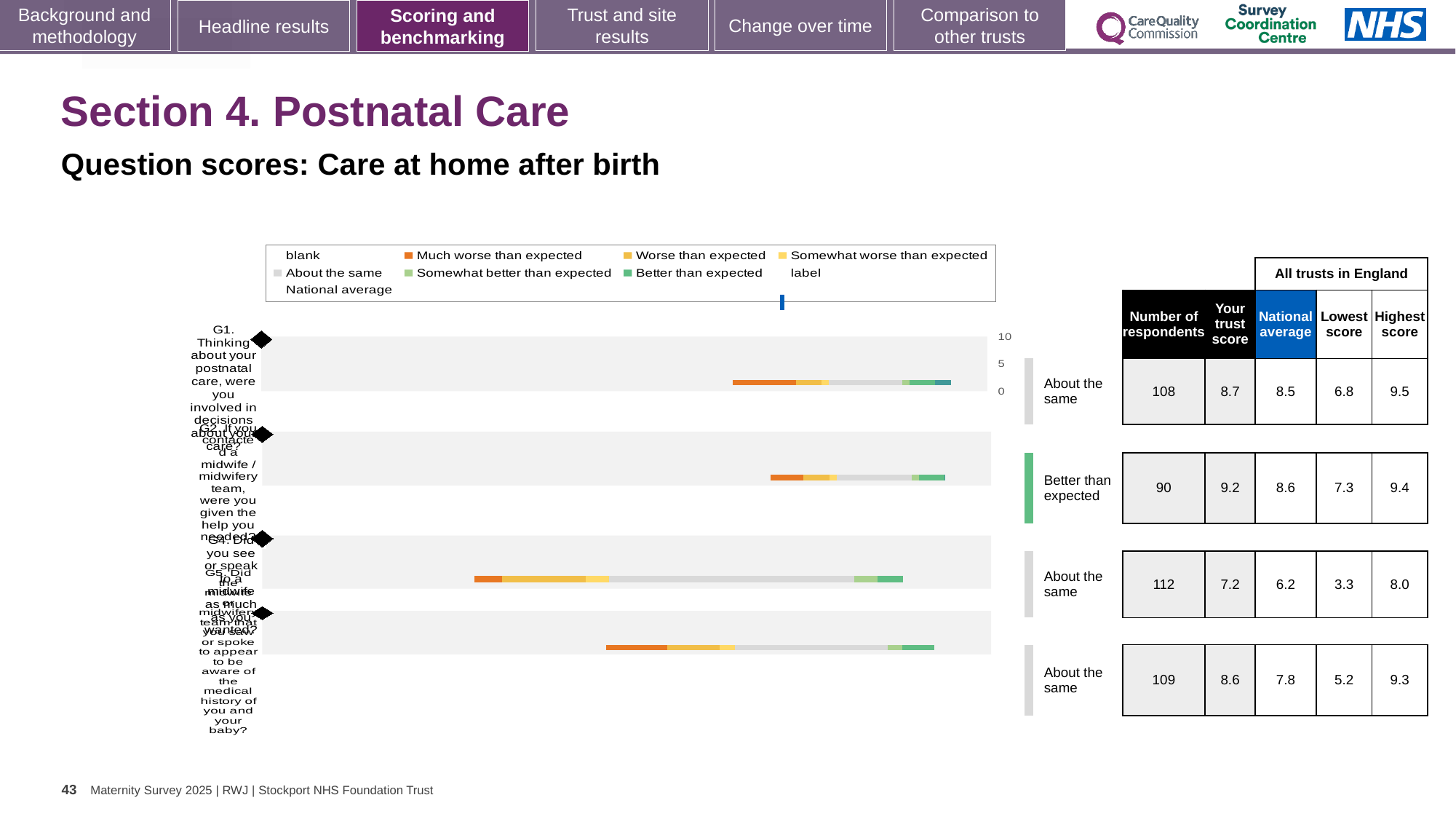
Is the trust score for the first row (G1) larger or smaller than its national average? larger In the table, what is the number of respondents for the first row (G1)? 108 In the table, what is the lowest score for the fourth row (G5)? 5.2 What kind of chart is shown on the slide? bar chart Which row has the lowest 'Your trust score' in the table? G4 (third row), 7.2 In the table, what is the trust score for the row rated 'Better than expected'? 9.2 What is the difference between the trust score and the national average for the third row (G4)? 1.0 Which legend entry is shown in orange? Much worse than expected Which row has the highest 'Your trust score' in the table? Better than expected (G2), 9.2 What is the highest score in England for the first row (G1)? 9.5 In the table, what is the national average for the third row (G4)? 6.2 How many question rows (G1, G2, G4, G5) are plotted in the chart? 4